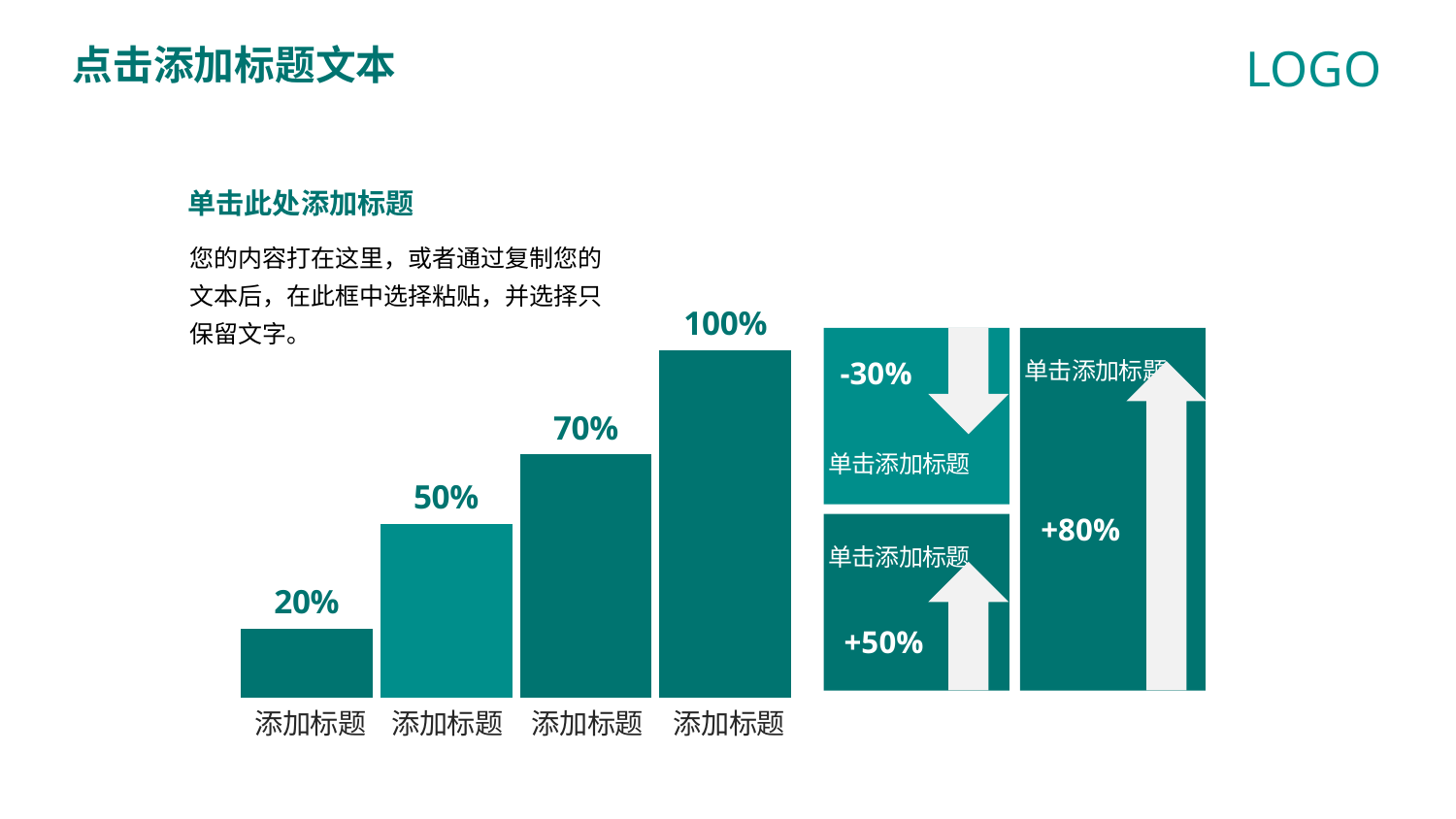
What is the difference between the values of the fourth bar and the first bar in the bar chart? 80% What is the difference between the values of the third bar and the second bar in the bar chart? 20% Do the bar values rise or fall from left to right in the bar chart? rise What is the value shown on the first (leftmost) bar of the bar chart? 20% What is the value shown on the fourth (rightmost) bar of the bar chart? 100% What is the value shown on the third bar of the bar chart? 70% Which bar in the bar chart has the highest value? the fourth (rightmost) bar, 100% How many bars does the bar chart have? 4 Which bar in the bar chart has the lowest value? the first (leftmost) bar, 20% What kind of chart is shown on the slide? bar chart What is the value shown on the second bar of the bar chart? 50% What label is printed under each bar of the bar chart? 添加标题